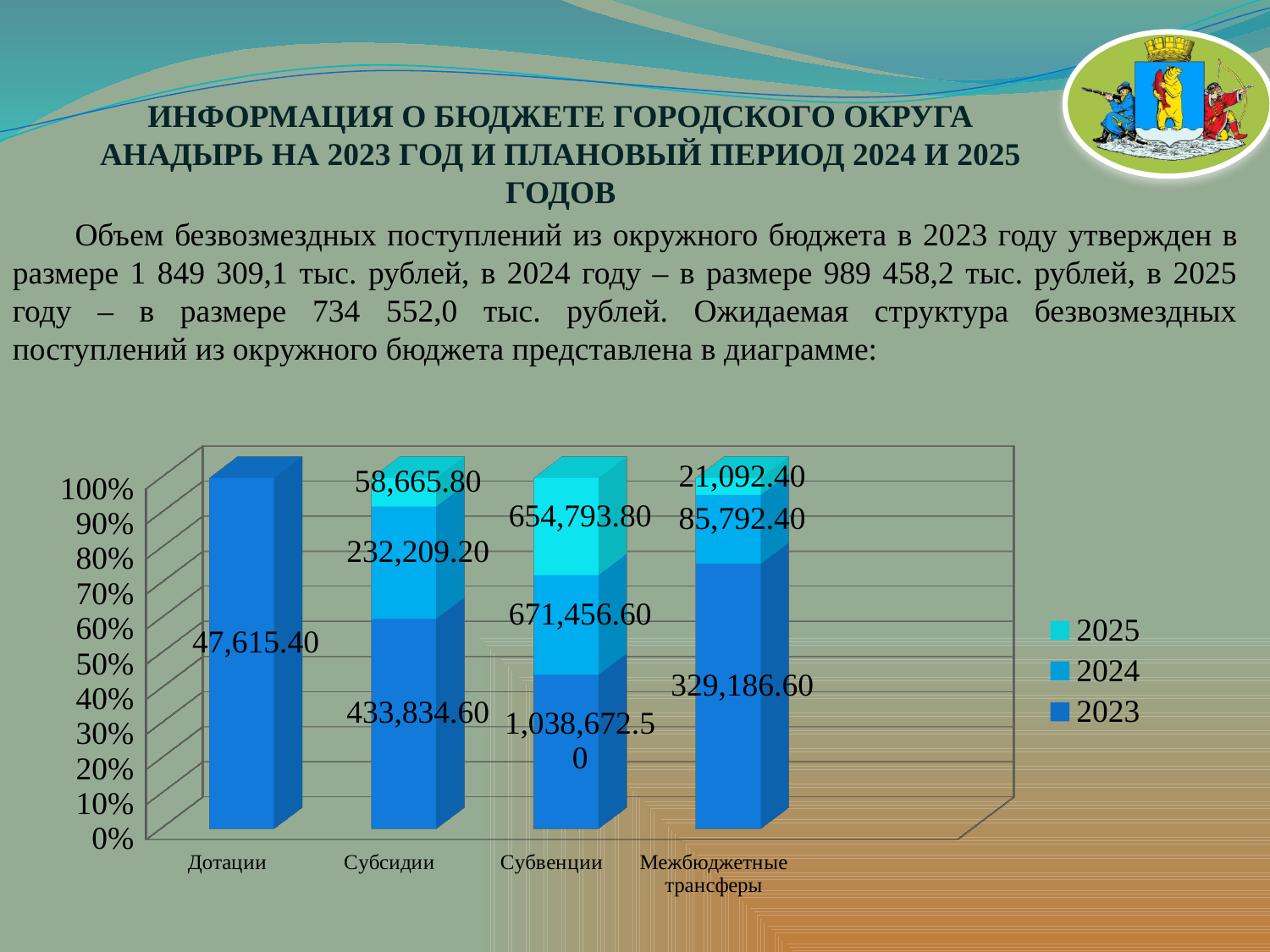
What is the 2023 value for Субвенции? 1,038,672.50 What is the 2025 value for Субсидии? 58,665.80 What is the total of the three values in the Межбюджетные трансферы bar? 436,071.40 Which is larger: the 2024 value for Субвенции or the 2024 value for Субсидии? 2024 value for Субвенции What is the 2023 value for Дотации? 47,615.40 What is the 2024 value for Межбюджетные трансферы? 85,792.40 Which category has the highest 2023 value? Субвенции Which category has the highest 2025 value? Субвенции How many categories are shown on the x axis? 4 What kind of chart is shown on the slide? Stacked bar chart What is the difference between the 2023 and 2024 values for Субсидии? 201,625.40 How many series does the legend list? 3